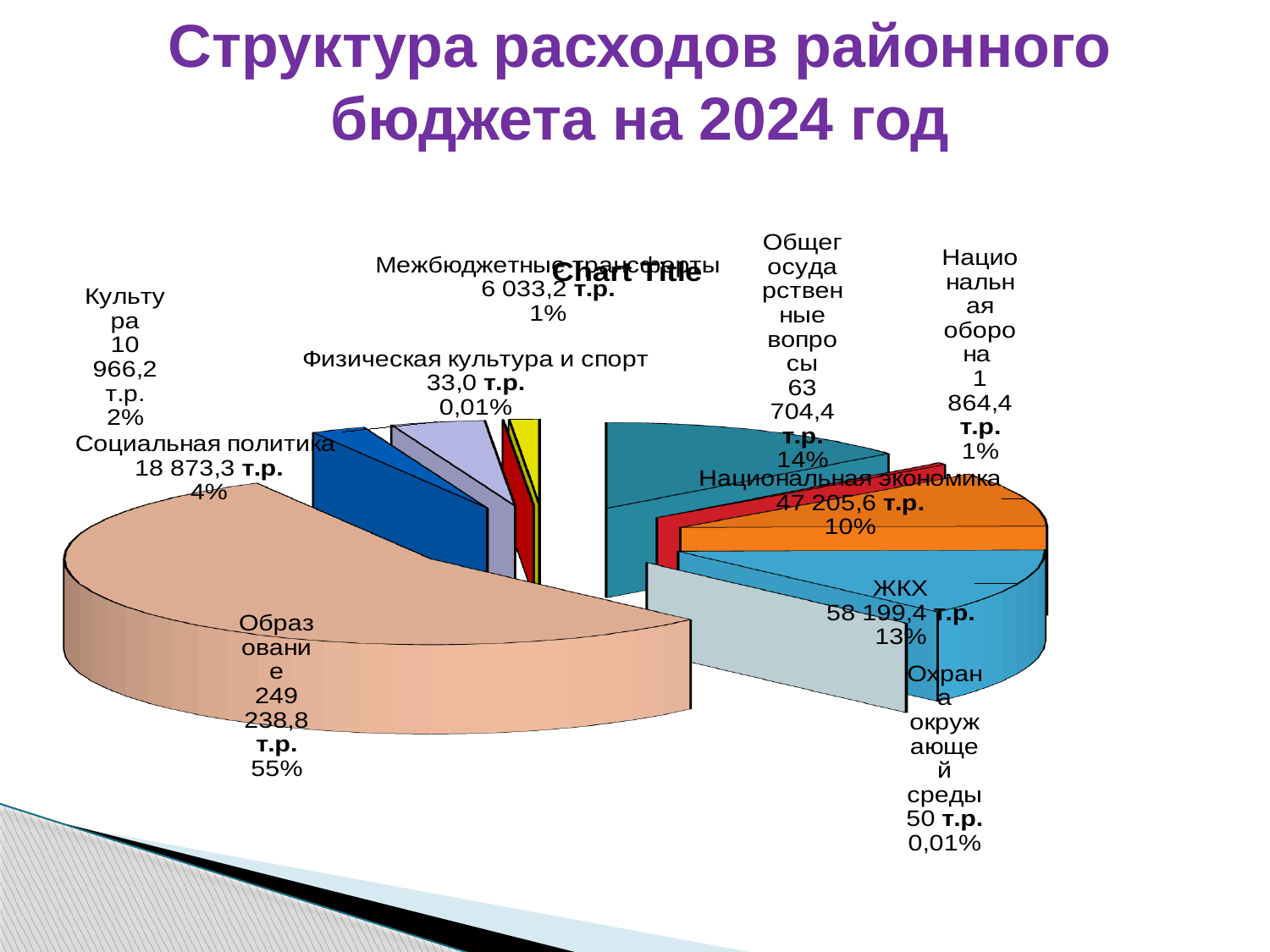
What is the value for Социальная политика? 18 873,3 т.р. What is the difference between Общегосударственные вопросы and ЖКХ? 5 505,0 т.р. What is the value for ЖКХ? 58 199,4 т.р. Which category has the smallest value? Физическая культура и спорт What is the value for Образование? 249 238,8 т.р. What is the value for Общегосударственные вопросы? 63 704,4 т.р. Which is larger, ЖКХ or Национальная экономика? ЖКХ What share of the pie does Национальная экономика represent? 10% Which category has the largest value? Образование What kind of chart is shown on the slide? pie chart How many categories (slices) does the pie chart show? 10 What share of the pie does Образование represent? 55%